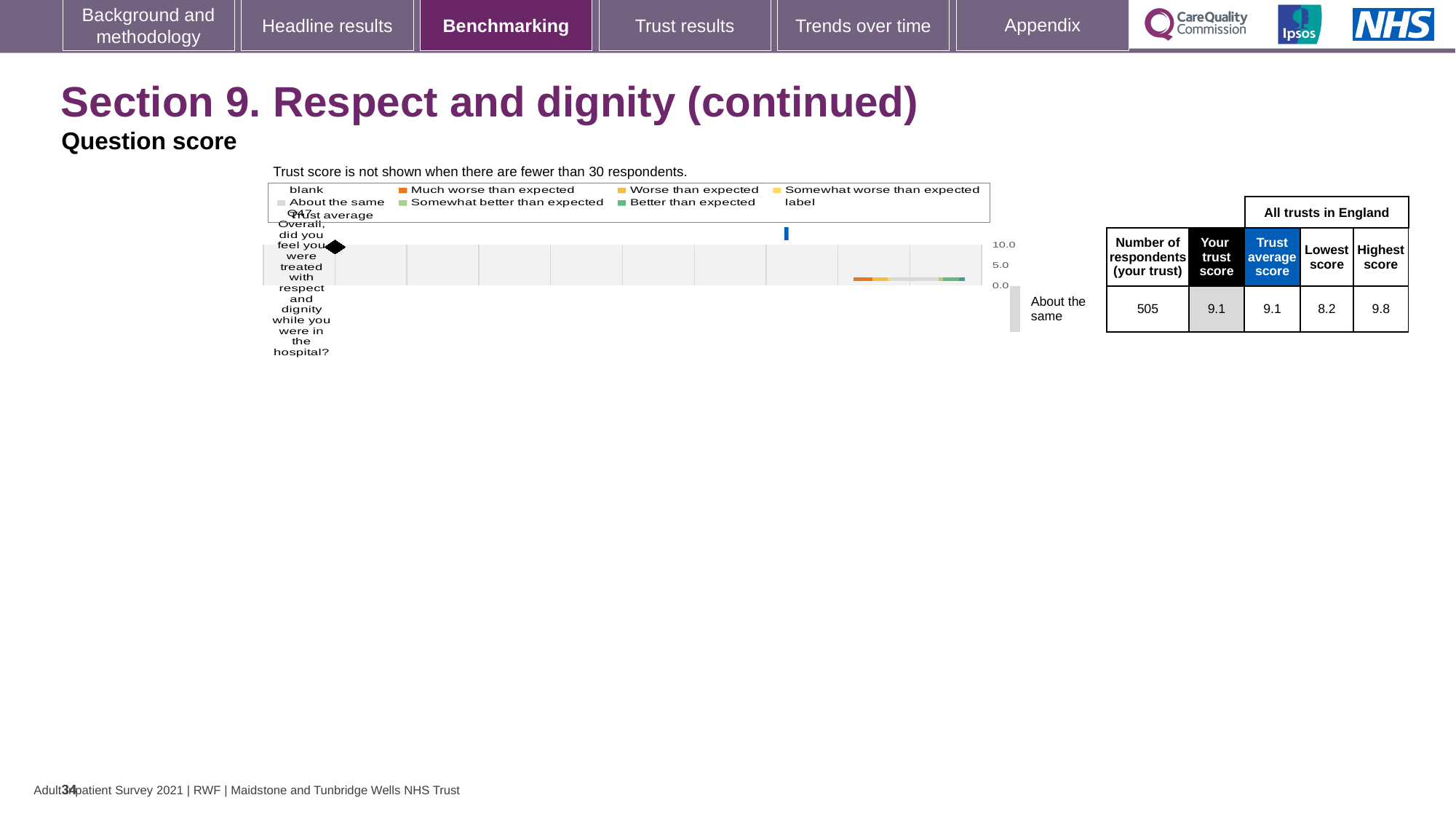
What is the lowest score across all trusts in England for Q47? 8.2 How many respondents from the trust answered Q47? 505 Which is larger for Q47: the trust's own score or the highest score across all trusts in England? Highest score What is the highest tick value shown on the chart's score axis? 10.0 What is the highest score across all trusts in England for Q47? 9.8 How many questions (categories) are plotted on the chart? 1 Is the trust average marker for Q47 greater or less than 5.0? greater What is the difference between the highest and lowest scores across all trusts in England for Q47? 1.6 What benchmark category is Q47 placed in on the chart? About the same What kind of chart is shown on the slide? bar chart Which question is plotted on the chart? Q47 What is the trust score for Q47 shown in the table beside the chart? 9.1